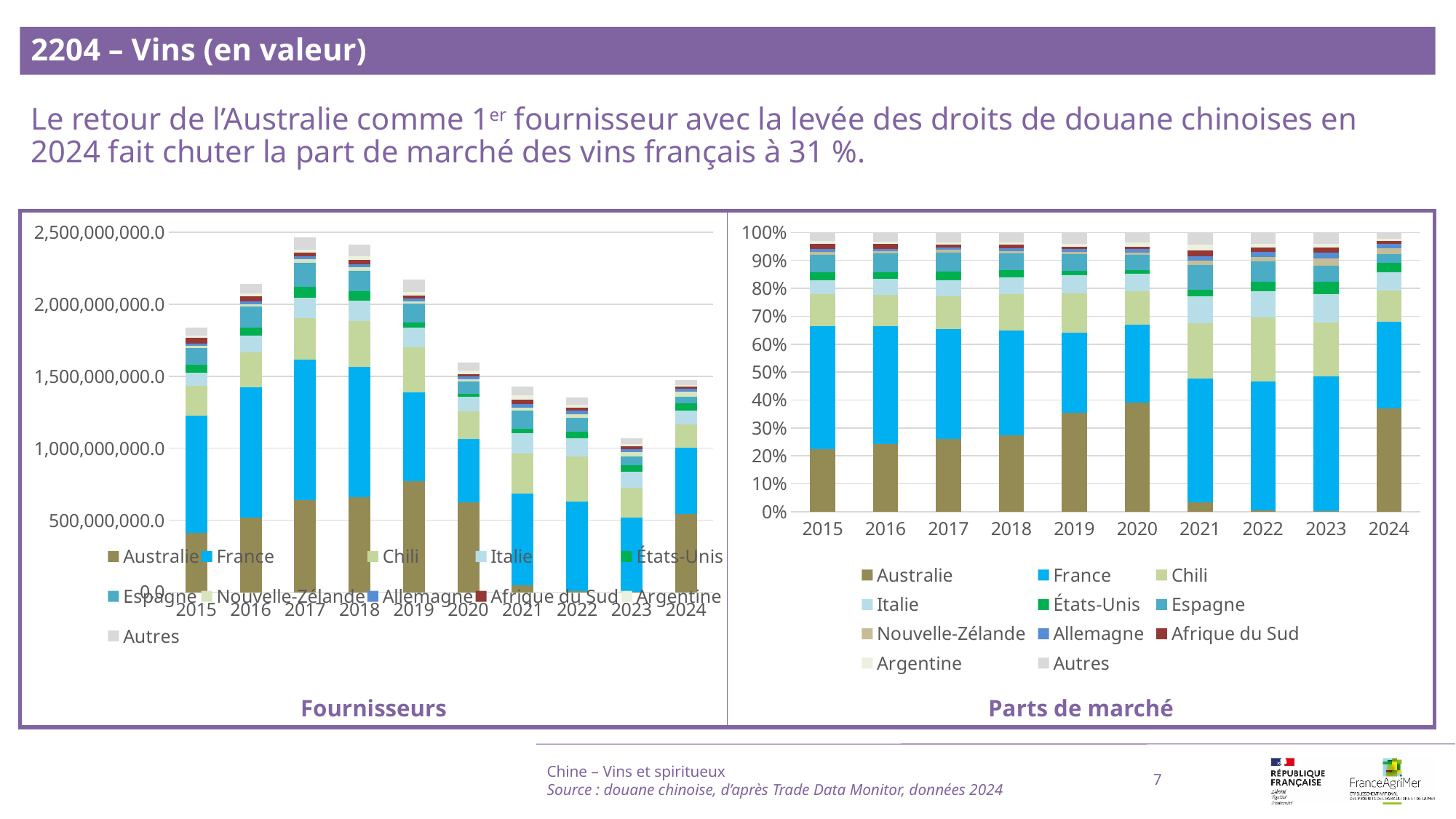
In the 'Fournisseurs' chart, which year has the highest total bar? 2017 In the 'Parts de marché' chart, is the share of Australie in 2021 greater or less than 10%? less In the 'Fournisseurs' chart, do the total bars rise or fall from 2017 to 2023? fall What kind of chart is the 'Fournisseurs' chart on the left? stacked bar chart In the 'Fournisseurs' chart, which year has the larger total bar, 2018 or 2020? 2018 In the 'Fournisseurs' chart, which year has the lowest total bar? 2023 How many series does the legend of the 'Parts de marché' chart list? 11 In the 'Fournisseurs' chart, is the total for 2023 greater or less than 1,500,000,000.0? less How many years are shown on the x axis of the 'Parts de marché' chart? 10 In the 'Fournisseurs' chart, is the total for 2017 greater or less than 2,000,000,000.0? greater What is the title shown under the right-hand chart? Parts de marché